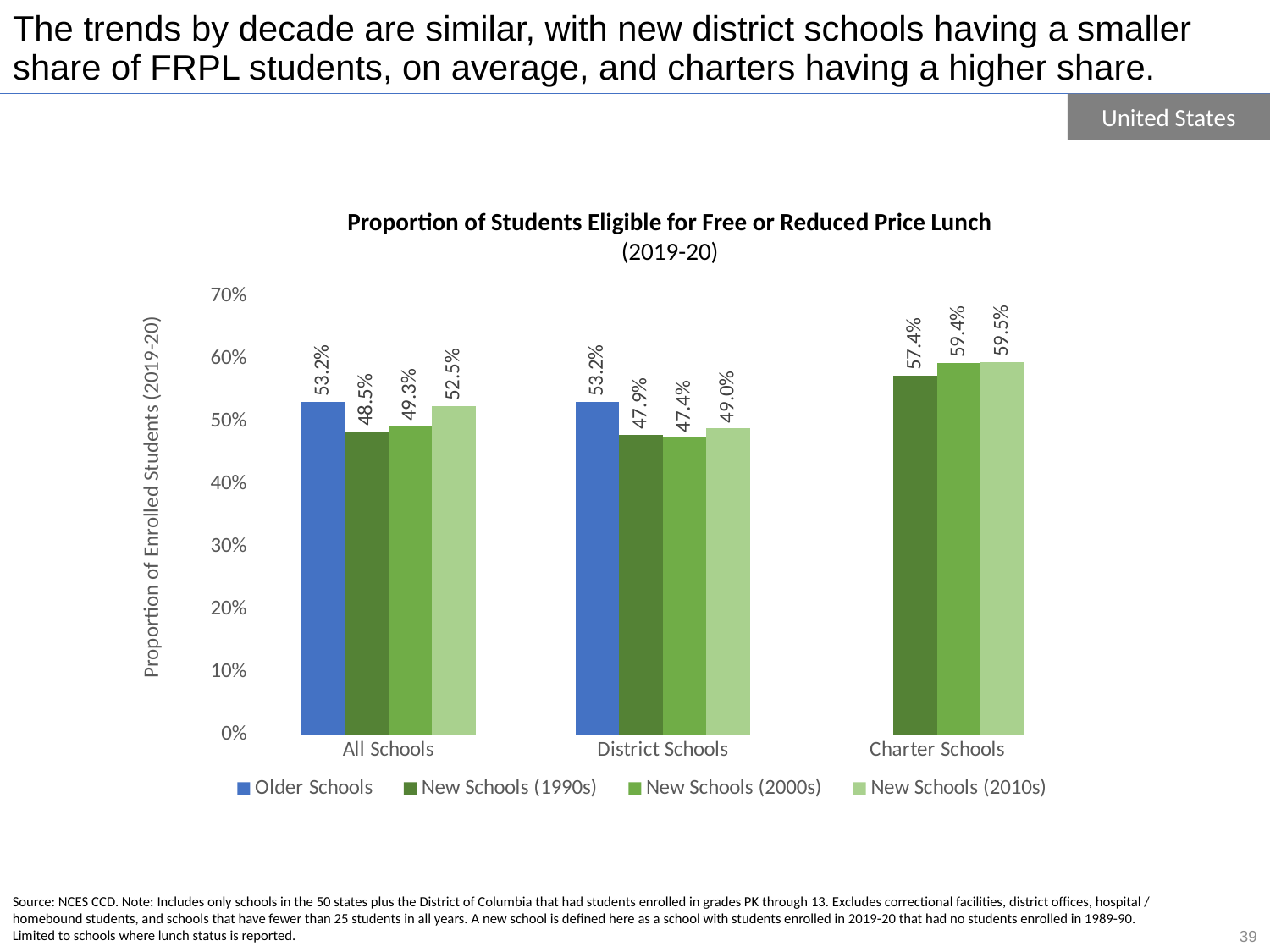
How many categories are shown on the x axis? 3 What is the value for New Schools (2010s) in the All Schools category? 52.5% What kind of chart is shown on the slide? Bar chart How many series does the legend list? 4 What is the difference between the Older Schools value and the New Schools (1990s) value in the All Schools category? 4.7% What is the value for New Schools (1990s) in the District Schools category? 47.9% Which series has the highest value in the Charter Schools category? New Schools (2010s) Which series has the lowest value in the District Schools category? New Schools (2000s) Is the value for New Schools (2000s) in the District Schools category greater or less than 50%? less What is the title of the chart? Proportion of Students Eligible for Free or Reduced Price Lunch (2019-20)